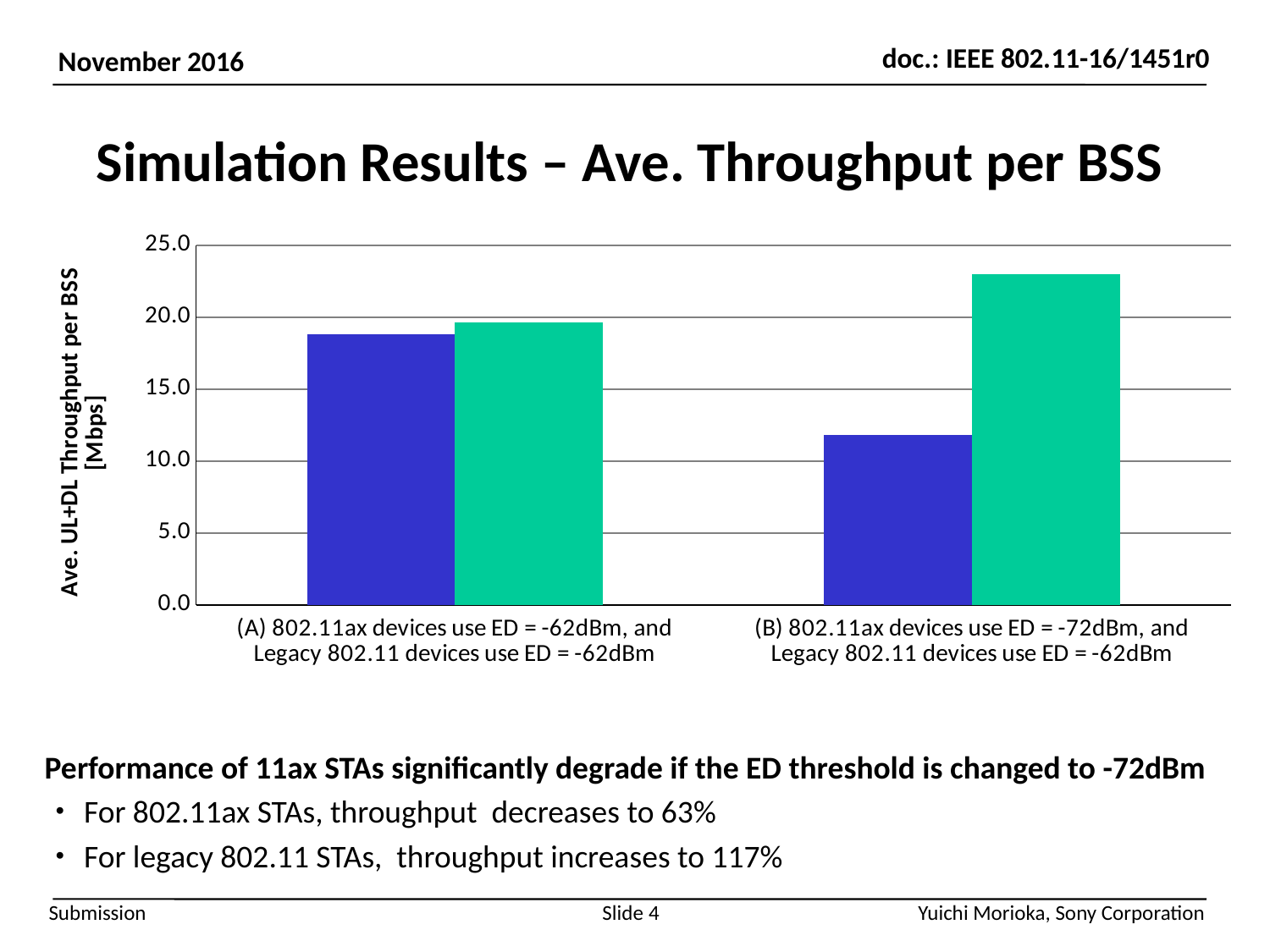
Do the blue bars rise or fall from category (A) to category (B)? fall Is the value of the blue bar for category (B) 802.11ax devices use ED = -72dBm greater or less than 15.0? less How many bars are plotted for each category in the chart? 2 What kind of chart is shown on the slide? bar chart How many categories are shown on the x axis of the chart? 2 Is the value of the green bar for category (B) 802.11ax devices use ED = -72dBm greater or less than 20.0? greater Which bar is the tallest in the chart? the green bar for (B) 802.11ax devices use ED = -72dBm Is the value of the blue bar for category (A) 802.11ax devices use ED = -62dBm greater or less than 15.0? greater Which bar is the shortest in the chart? the blue bar for (B) 802.11ax devices use ED = -72dBm What is the label of the y axis of the chart? Ave. UL+DL Throughput per BSS [Mbps] For the blue bars, is the value larger in category (A) or category (B)? (A)